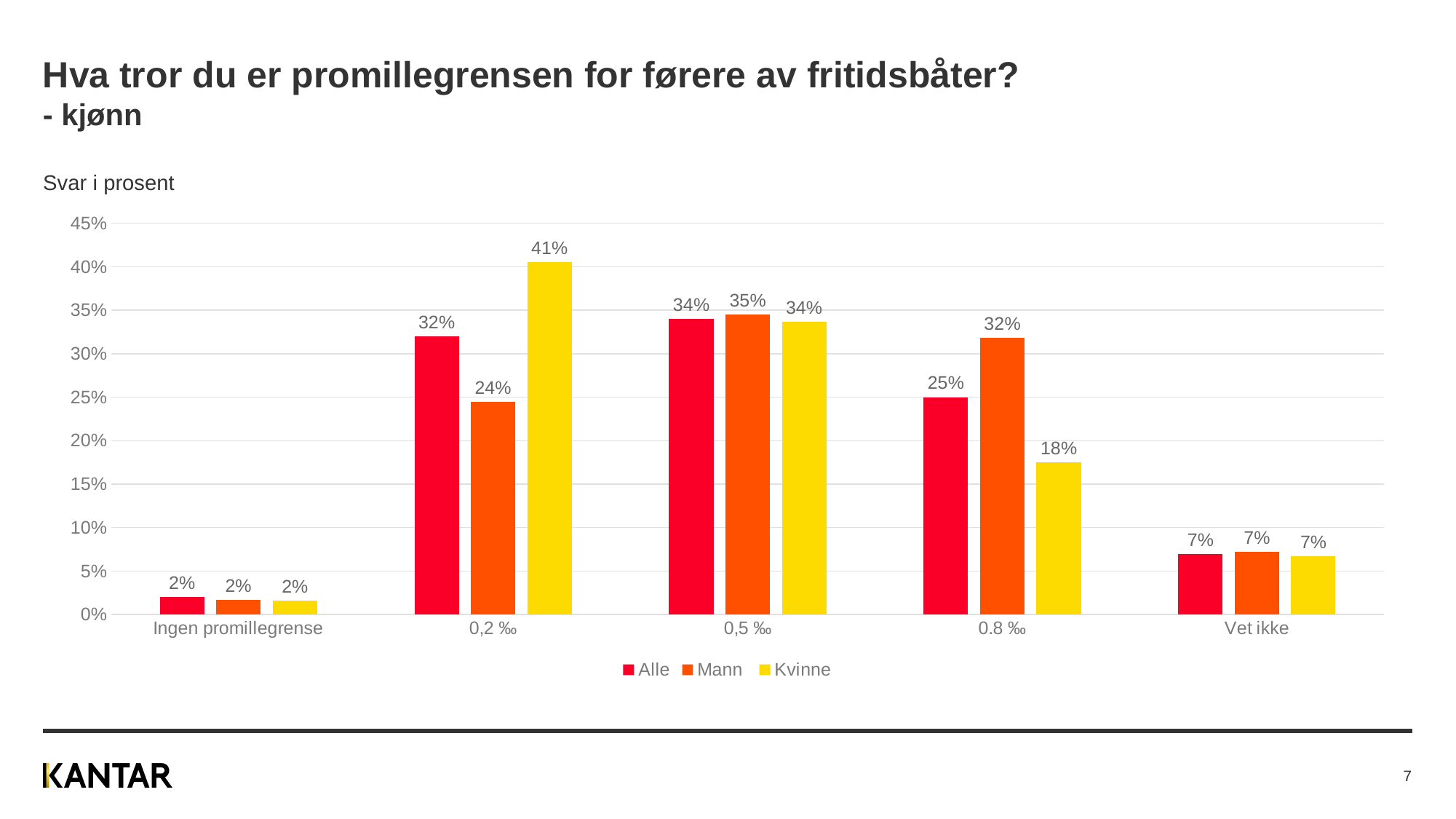
How many series does the legend list? 3 Is the value for Kvinne in the 0,2 ‰ category greater or less than 40%? greater What is the value for Kvinne in the 0,2 ‰ category? 41% What is the difference between the Kvinne and Mann values in the 0,2 ‰ category? 17 percentage points Which category has the highest value for the Kvinne series? 0,2 ‰ In the 0.8 ‰ category, which is larger: the Mann value or the Kvinne value? Mann What is the value for Mann in the 0.8 ‰ category? 32% Which category has the lowest value for the Alle series? Ingen promillegrense What is the value for Alle in the 0,5 ‰ category? 34% Which series is shown in yellow in the legend? Kvinne What kind of chart is shown on the slide? Bar chart How many categories are shown on the x axis? 5